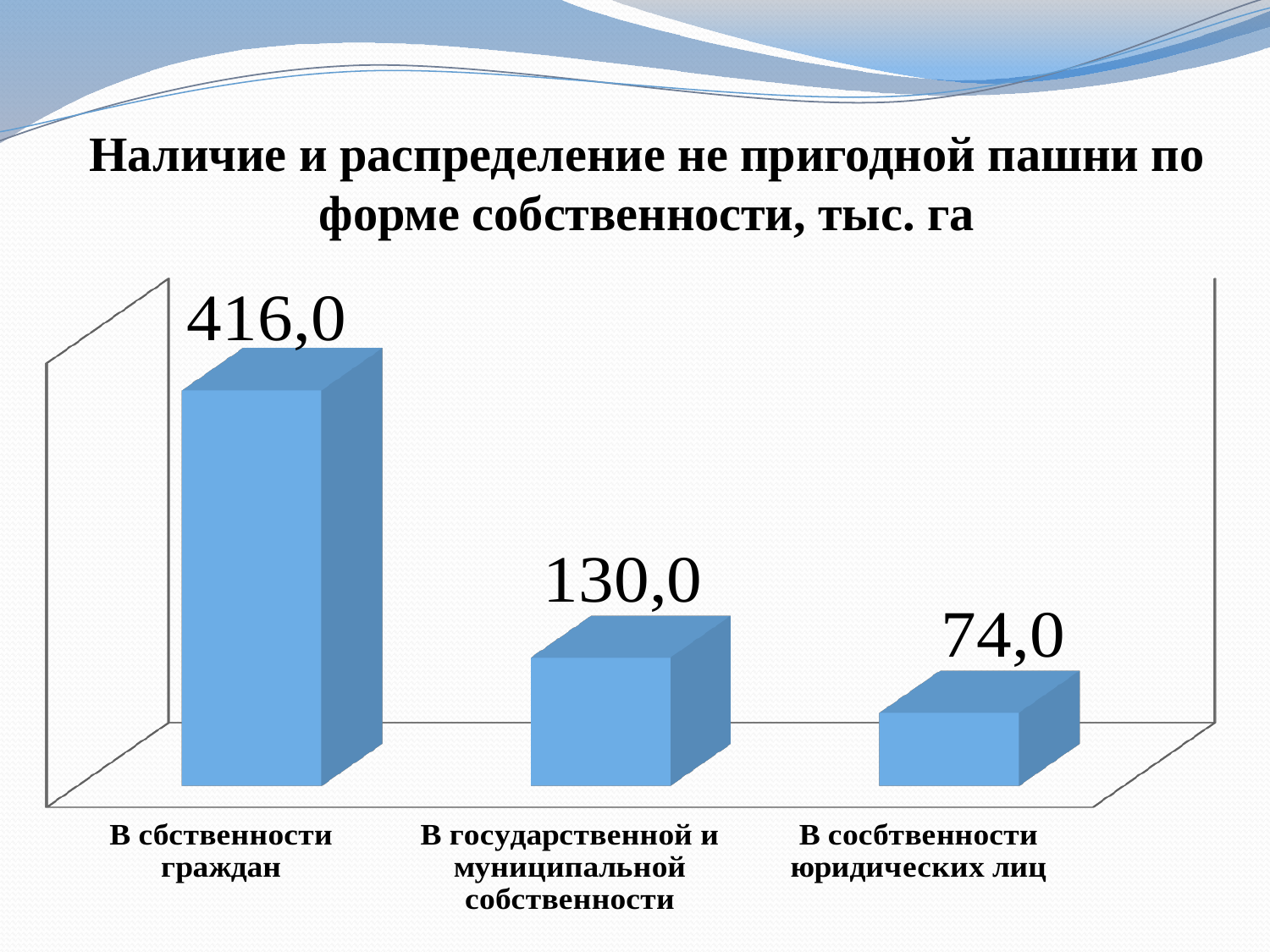
What is the difference between the values for 'В сбственности граждан' and 'В государственной и муниципальной собственности'? 286,0 What unit of measurement is given in the chart title? тыс. га What is the value for 'В государственной и муниципальной собственности'? 130,0 What kind of chart is shown on the slide? Bar chart Which category has the highest value? В сбственности граждан Which category has the lowest value? В сосбтвенности юридических лиц What is the difference between the values for 'В государственной и муниципальной собственности' and 'В сосбтвенности юридических лиц'? 56,0 Do the values rise or fall from left to right across the categories? Fall What is the value for 'В сбственности граждан'? 416,0 How many categories are shown in the chart? 3 What is the value for 'В сосбтвенности юридических лиц'? 74,0 Which is larger: the value for 'В государственной и муниципальной собственности' or for 'В сосбтвенности юридических лиц'? В государственной и муниципальной собственности